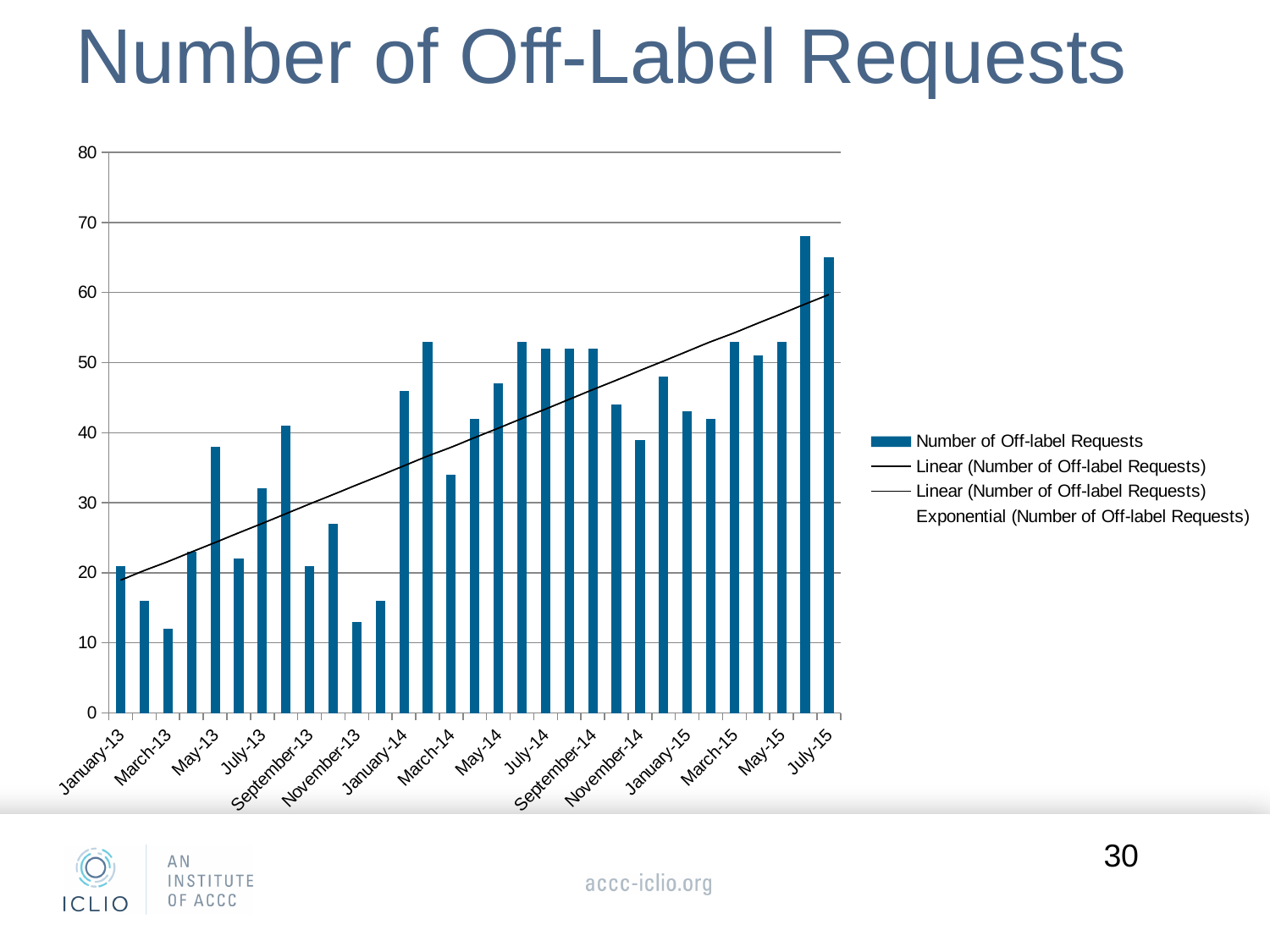
Is the value for November-13 greater or less than 20? less What kind of chart is shown on the slide? bar chart Which is larger, the value for July-15 or the value for January-13? July-15 What is the title of the chart? Number of Off-Label Requests How many bars are plotted in the chart? 31 Which is larger, the value for May-13 or the value for March-13? May-13 Is the value for January-14 greater or less than 40? greater Is the value for May-13 greater or less than 30? greater Overall, do the values rise or fall from January-13 to July-15? rise How many entries does the legend list? 4